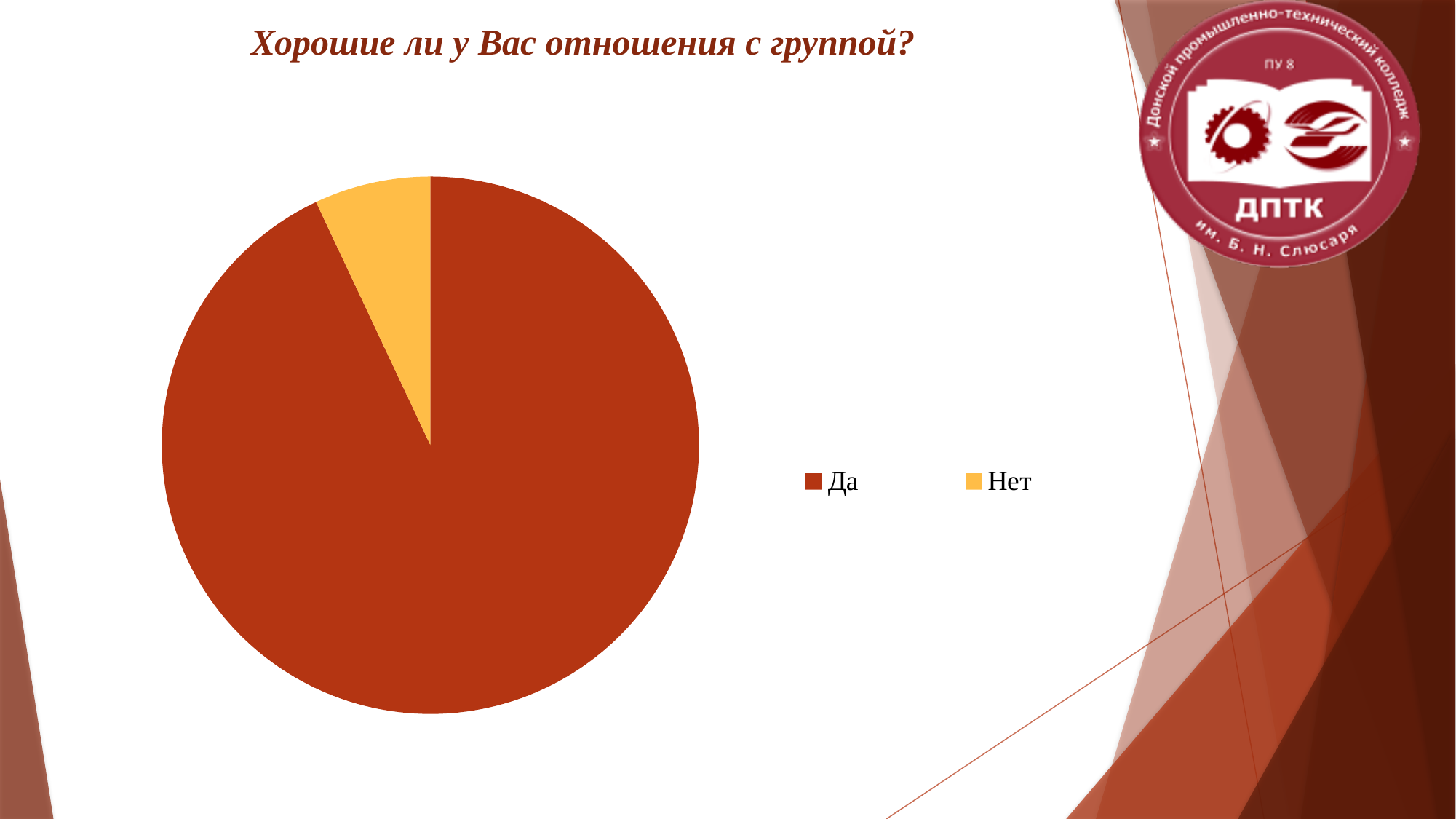
How many categories does the legend of the pie chart list? 2 Which category has the largest slice of the pie chart? Да What kind of chart is shown on the slide? pie chart How many slices does the pie chart have? 2 What is the title of the chart on the slide? Хорошие ли у Вас отношения с группой? What colour is the slice for Нет in the pie chart? yellow Which slice is larger, Да or Нет? Да Which category has the smallest slice of the pie chart? Нет